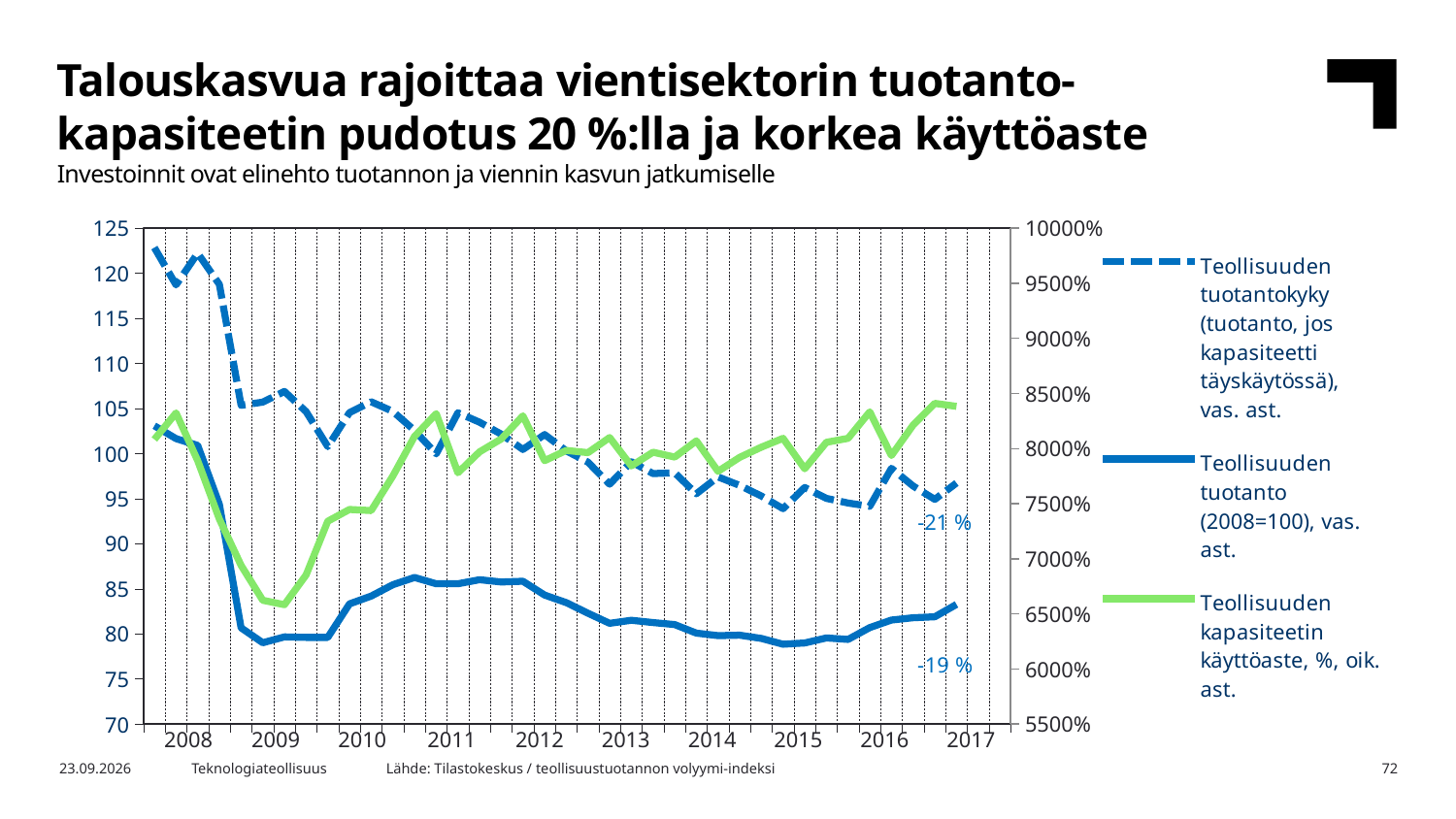
How many year labels are shown on the x axis? 10 Which series has the highest value at the start of 2008? Teollisuuden tuotantokyky What is the maximum value shown on the left vertical axis? 125 In 2017, which is higher: the dashed blue line (Teollisuuden tuotantokyky) or the solid blue line (Teollisuuden tuotanto)? Teollisuuden tuotantokyky What percentage annotation is printed near the end of the dashed blue line? -21 % Does the solid blue line (Teollisuuden tuotanto) rise or fall between 2008 and 2009? fall What kind of chart is shown on the slide? line chart Is the value of the solid blue line (Teollisuuden tuotanto) in 2009 greater or less than 85? less Is the value of the dashed blue line (Teollisuuden tuotantokyky) in 2017 greater or less than 100? less How many series does the legend list? 3 Is the value of the dashed blue line (Teollisuuden tuotantokyky) at the start of 2008 greater or less than 120? greater